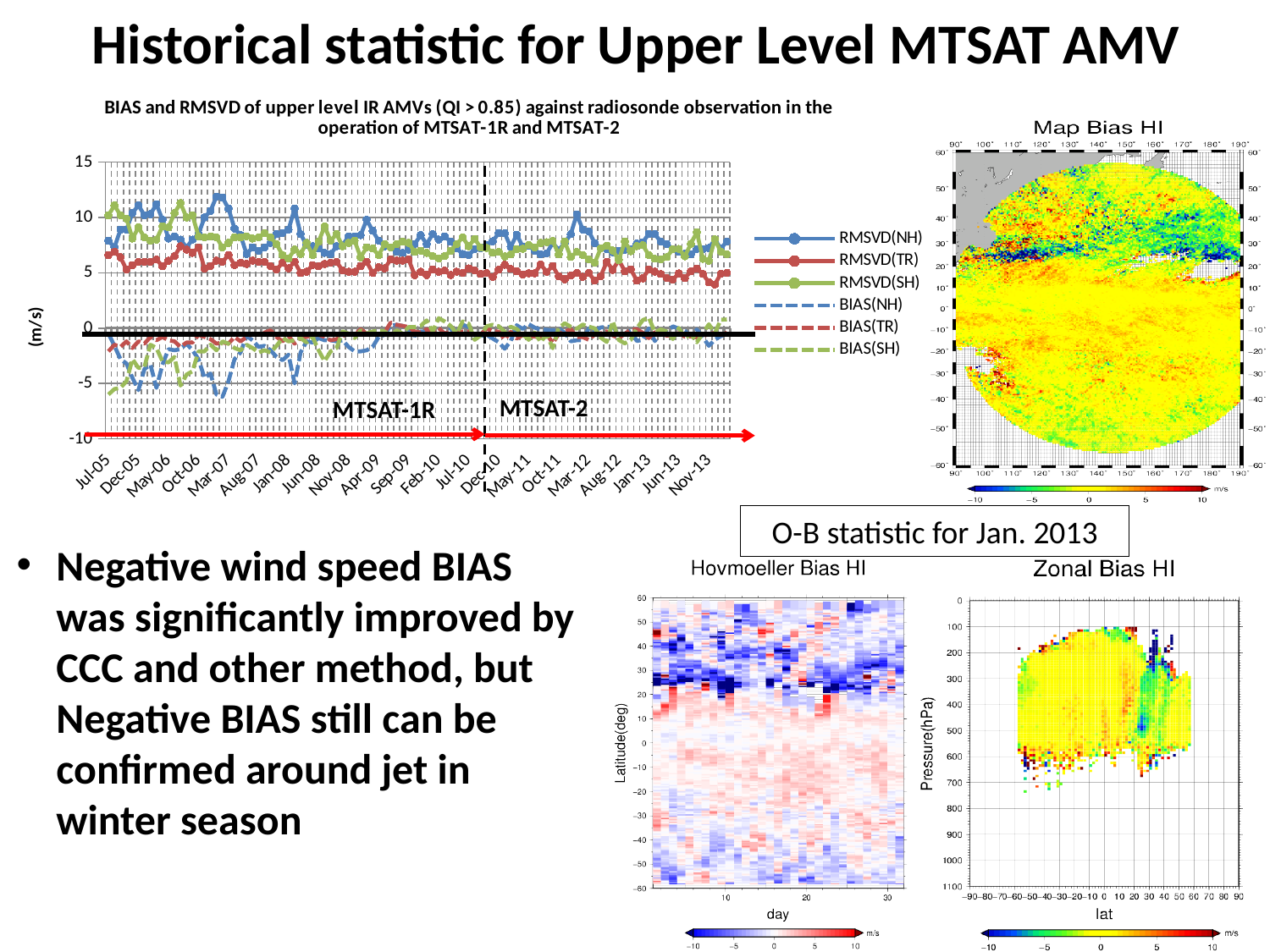
What unit is shown on the y axis of the 'BIAS and RMSVD of upper level IR AMVs' line chart? (m/s) What is the title of the map plot at the top right of the slide? Map Bias HI In the 'BIAS and RMSVD of upper level IR AMVs' line chart, is the value of RMSVD(NH) around Mar-07 greater or less than 10? greater In the 'BIAS and RMSVD of upper level IR AMVs' line chart, is the value of RMSVD(TR) around Nov-13 greater or less than 10? less How many series does the legend of the 'BIAS and RMSVD of upper level IR AMVs' line chart list? 6 In the 'BIAS and RMSVD of upper level IR AMVs' line chart, which of the three RMSVD series is generally the lowest? RMSVD(TR) In the 'BIAS and RMSVD of upper level IR AMVs' line chart, is the value of RMSVD(TR) around Mar-07 greater or less than 10? less What kind of chart is the 'BIAS and RMSVD of upper level IR AMVs' chart at the top left of the slide? line chart In the 'BIAS and RMSVD of upper level IR AMVs' line chart, which is larger around Mar-07: RMSVD(NH) or RMSVD(TR)? RMSVD(NH) In the 'BIAS and RMSVD of upper level IR AMVs' line chart, does BIAS(NH) generally rise or fall from Jul-05 to Nov-13? rise